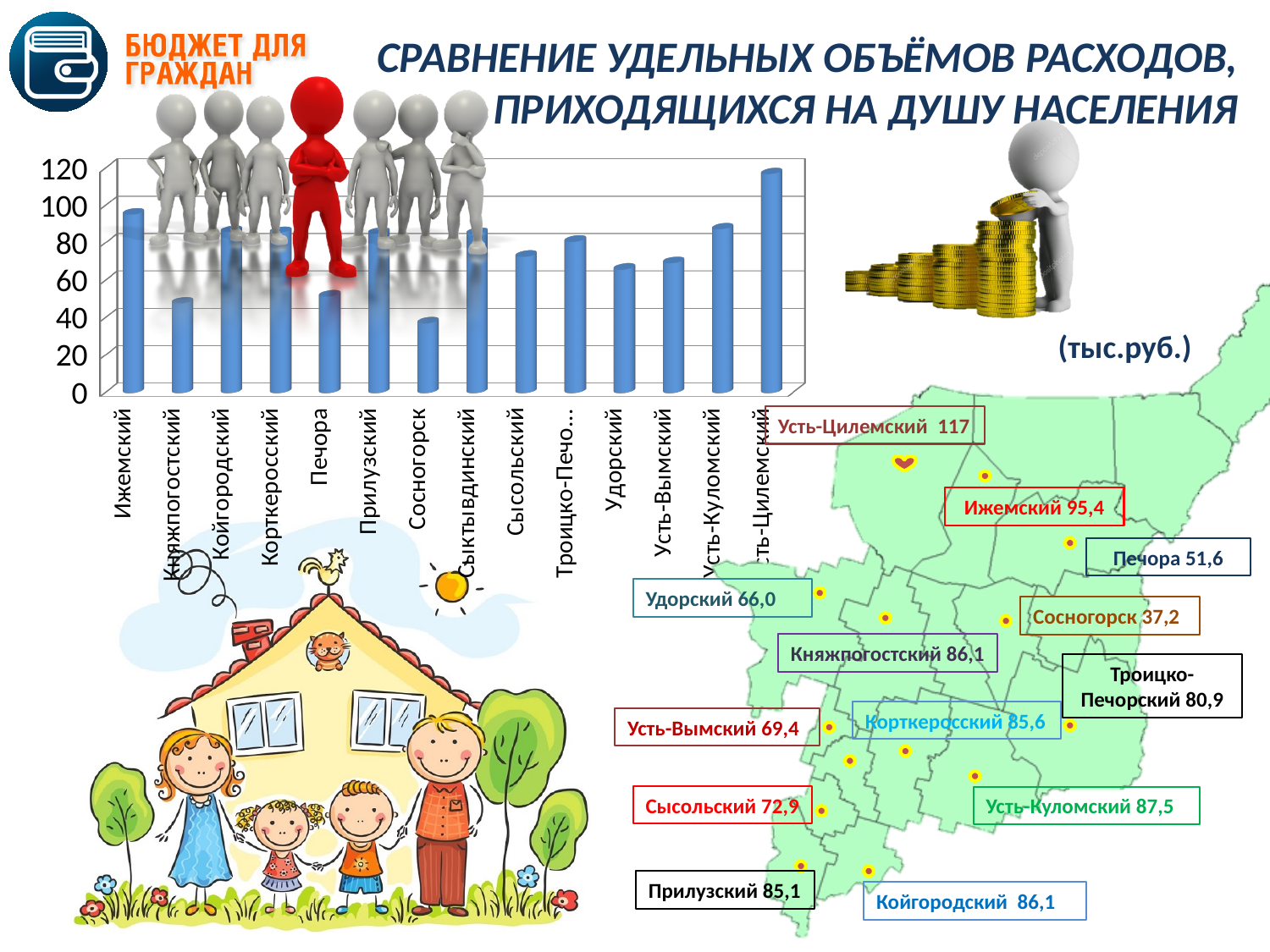
How many categories (districts) are plotted on the bar chart? 14 Which is larger, the value for Удорский or the value for Усть-Куломский? Усть-Куломский What kind of chart is shown on the slide? bar chart Which district has the highest bar on the chart? Усть-Цилемский Which is larger, the value for Ижемский or the value for Печора? Ижемский Is the value for Усть-Цилемский greater or less than 100? greater Is the value for Сыктывдинский greater or less than 80? greater According to the labels on the slide, what is the value for Усть-Цилемский? 117 Which district has the lowest bar on the chart? Сосногорск What unit of measurement is indicated for the values on the slide? тыс.руб. According to the labels on the slide, what is the value for Сосногорск? 37,2 Is the value for Княжпогостский greater or less than 60? less